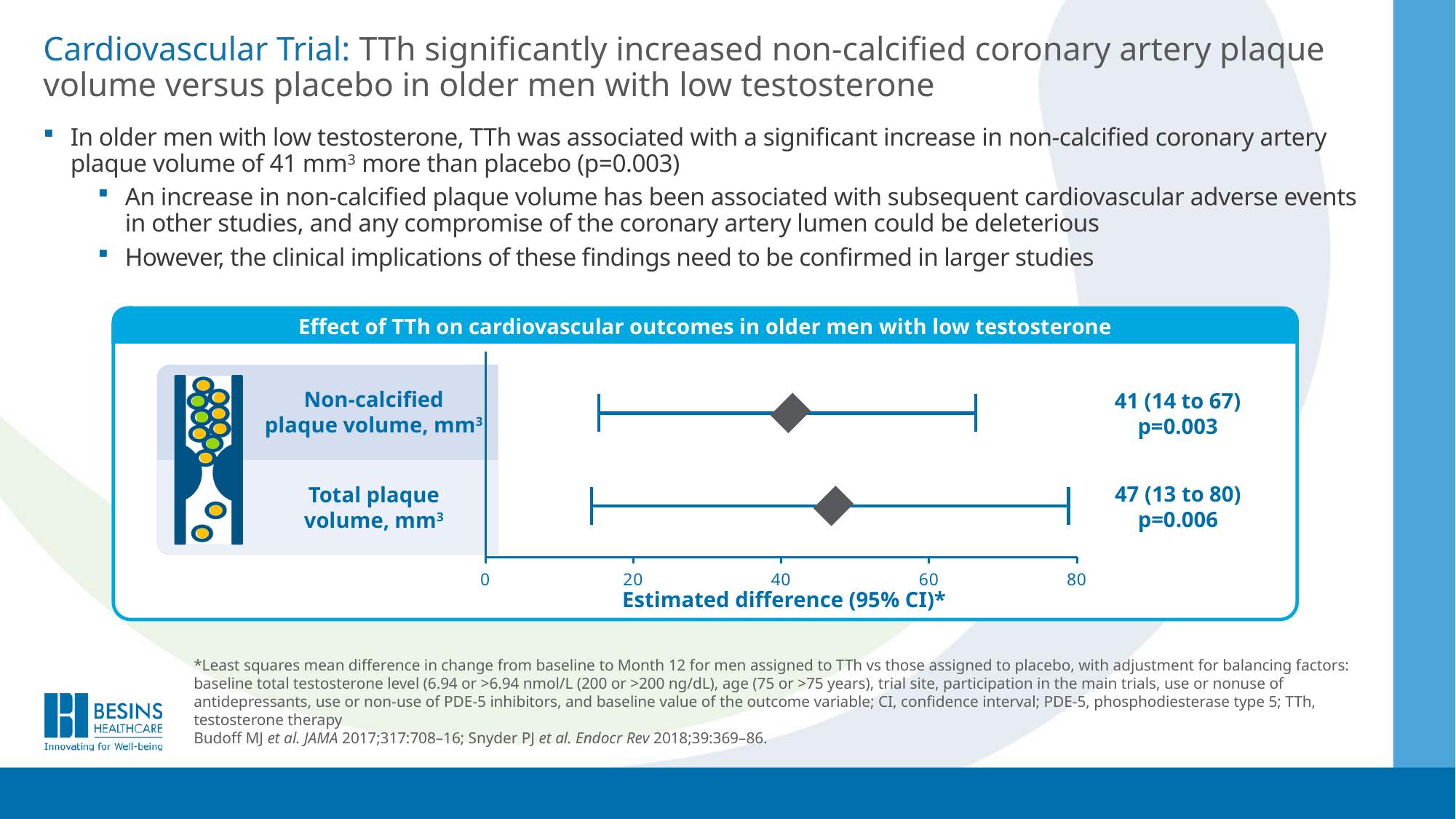
What is the label of the x axis? Estimated difference (95% CI)* Which outcome has the larger estimated difference, non-calcified plaque volume or total plaque volume? Total plaque volume What is the title of the chart? Effect of TTh on cardiovascular outcomes in older men with low testosterone How many outcomes are plotted in the chart? 2 What is the p-value shown for total plaque volume? p=0.006 What is the estimated difference for non-calcified plaque volume? 41 (14 to 67) What is the estimated difference for total plaque volume? 47 (13 to 80) What is the difference between the estimated differences for total plaque volume and non-calcified plaque volume? 6 Which outcome has the smallest estimated difference? Non-calcified plaque volume Is the upper confidence limit for non-calcified plaque volume greater or less than 80? less What is the p-value shown for non-calcified plaque volume? p=0.003 Is the estimated difference for total plaque volume greater or less than 40? greater